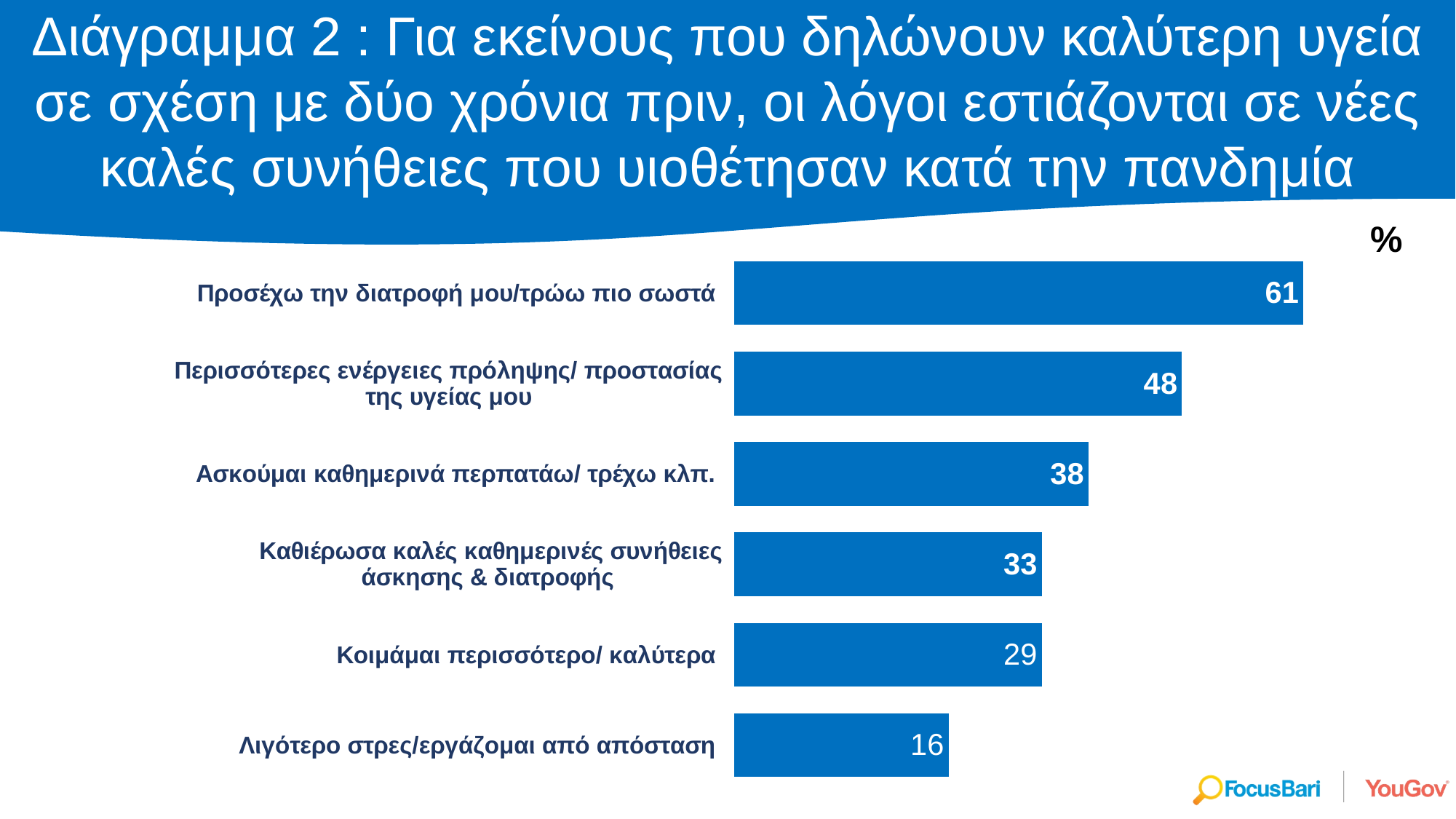
What is the value for "Κοιμάμαι περισσότερο/ καλύτερα"? 29 How many categories are shown in the chart? 6 What is the value for "Ασκούμαι καθημερινά περπατάω/ τρέχω κλπ."? 38 What unit symbol is shown at the top right of the chart? % Do the values rise or fall going from the top bar to the bottom bar? Fall What is the difference between the values for "Προσέχω την διατροφή μου/τρώω πιο σωστά" and "Περισσότερες ενέργειες πρόληψης/ προστασίας της υγείας μου"? 13 Which category has the highest value? Προσέχω την διατροφή μου/τρώω πιο σωστά Which category has the lowest value? Λιγότερο στρες/εργάζομαι από απόσταση What kind of chart is shown on the slide? Bar chart What is the difference between the values for "Καθιέρωσα καλές καθημερινές συνήθειες άσκησης & διατροφής" and "Λιγότερο στρες/εργάζομαι από απόσταση"? 17 What is the value for "Προσέχω την διατροφή μου/τρώω πιο σωστά"? 61 Which is larger: the value for "Ασκούμαι καθημερινά περπατάω/ τρέχω κλπ." or for "Κοιμάμαι περισσότερο/ καλύτερα"? Ασκούμαι καθημερινά περπατάω/ τρέχω κλπ.